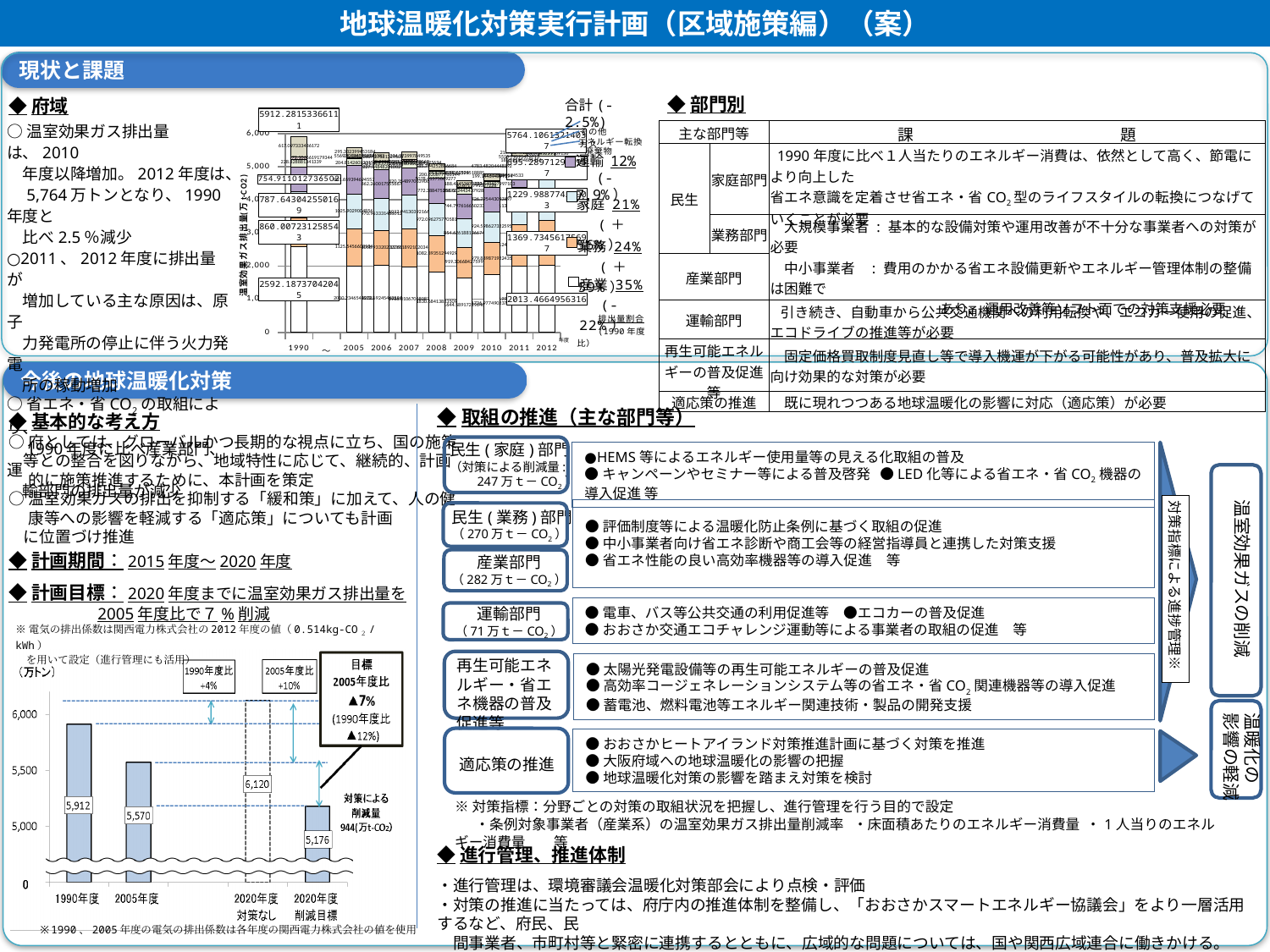
In the bottom-left bar chart, what is the value for 2020年度 対策なし? 6,120 In the bottom-left bar chart, what is the value for 2005年度? 5,570 In the bottom-left bar chart, what is the value for 2020年度 削減目標? 5,176 In the bottom-left bar chart, what is the value for 1990年度? 5,912 How many bars are plotted in the bottom-left chart? 4 In the bottom-left bar chart, what is the difference between 1990年度 and 2005年度? 342 In the bottom-left bar chart, which category has the lowest value? 2020年度 削減目標 In the bottom-left bar chart, which category has the highest value? 2020年度 対策なし In the bottom-left bar chart, is the value for 2005年度 greater or less than 5,500? greater In the bottom-left bar chart, what is the difference between 2020年度 対策なし and 2020年度 削減目標? 944 In the bottom-left bar chart, which is larger, 1990年度 or 2005年度? 1990年度 What kind of chart is the chart at the top of the slide showing 温室効果ガス排出量 by year? stacked bar chart